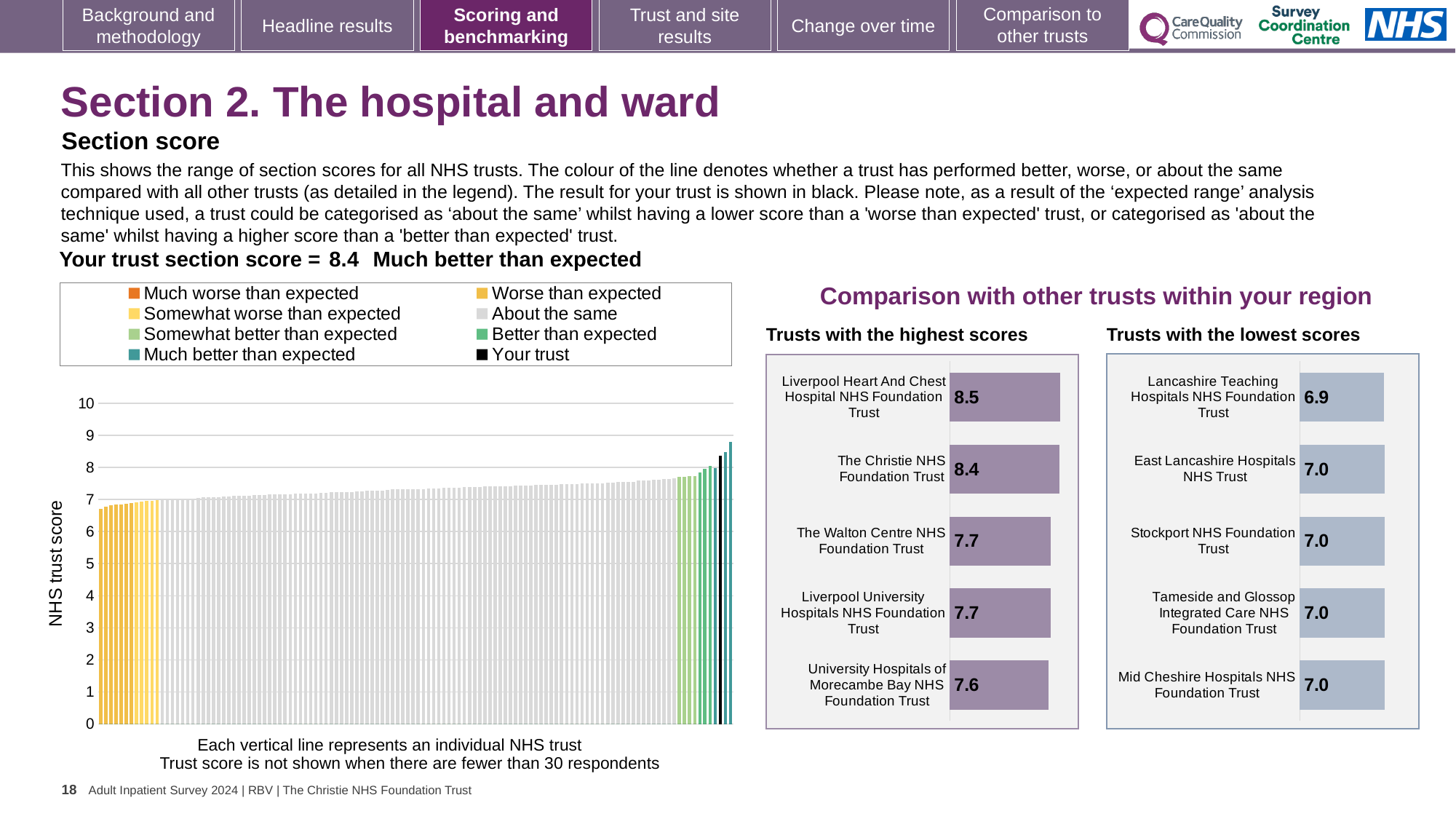
How many entries does the legend of the large chart on the left list? 8 In the large chart on the left, do the trust scores rise or fall from left to right? Rise In the 'Trusts with the highest scores' chart, what is the score for The Christie NHS Foundation Trust? 8.4 What kind of chart is the large chart on the left showing NHS trust scores? Bar chart Which is larger: the score for The Walton Centre NHS Foundation Trust in the highest scores chart, or the score for Stockport NHS Foundation Trust in the lowest scores chart? The Walton Centre NHS Foundation Trust In the 'Trusts with the lowest scores' chart, what is the score for Lancashire Teaching Hospitals NHS Foundation Trust? 6.9 In the 'Trusts with the highest scores' chart, what is the difference between the scores of Liverpool Heart And Chest Hospital NHS Foundation Trust and University Hospitals of Morecambe Bay NHS Foundation Trust? 0.9 In the 'Trusts with the highest scores' chart, which trust has the lowest score? University Hospitals of Morecambe Bay NHS Foundation Trust In the 'Trusts with the lowest scores' chart, what is the score for Mid Cheshire Hospitals NHS Foundation Trust? 7.0 In the 'Trusts with the highest scores' chart, how many trusts are shown? 5 In the 'Trusts with the lowest scores' chart, which trust has the lowest score? Lancashire Teaching Hospitals NHS Foundation Trust In the 'Trusts with the highest scores' chart, what is the score for Liverpool Heart And Chest Hospital NHS Foundation Trust? 8.5